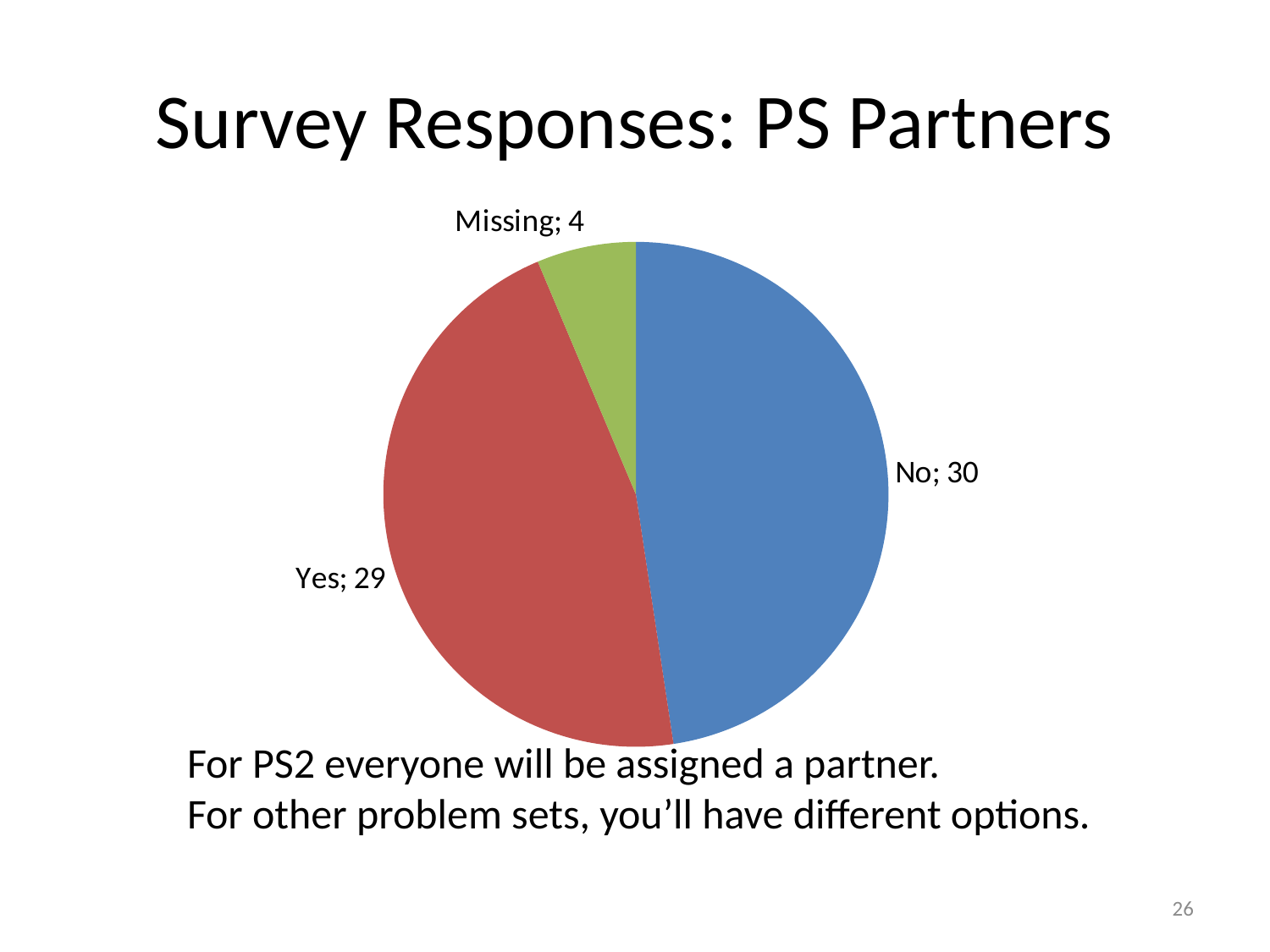
Which is larger, the value for "Yes" or the value for "Missing"? Yes How many slices does the pie chart have? 3 What type of chart is shown on the slide? pie chart What is the value for the "Missing" slice? 4 What is the value for the "Yes" slice? 29 What is the total of all three slices in the pie chart? 63 What is the difference between the "Yes" and "Missing" values? 25 What is the value for the "No" slice? 30 Which category has the largest value in the pie chart? No What is the title of the chart on the slide? Survey Responses: PS Partners Which category has the smallest value in the pie chart? Missing What is the difference between the "No" and "Yes" values? 1